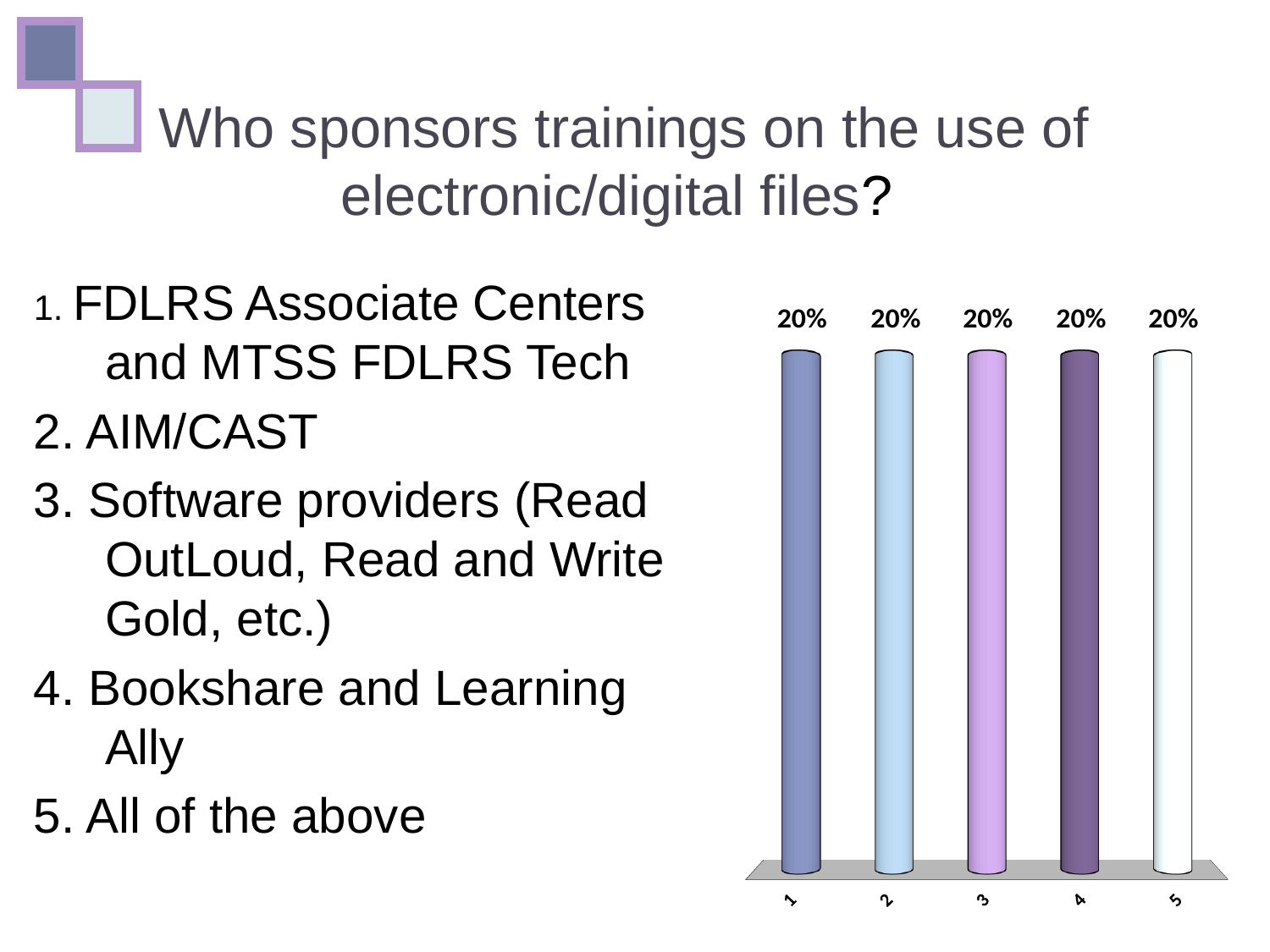
What is the total of all five bar values? 100% How many categories are plotted on the chart? 5 What value is shown for category 1? 20% What kind of chart is shown on the slide? Bar chart Are all five bars the same height? Yes What is the difference between the values for category 1 and category 4? 0% What value is shown for category 5? 20% Do the values rise, fall, or stay the same across categories 1 to 5? Stay the same What value is shown for category 2? 20% What value is shown for category 3? 20% Does the chart have a legend? No What colour is the bar for category 3? Light purple